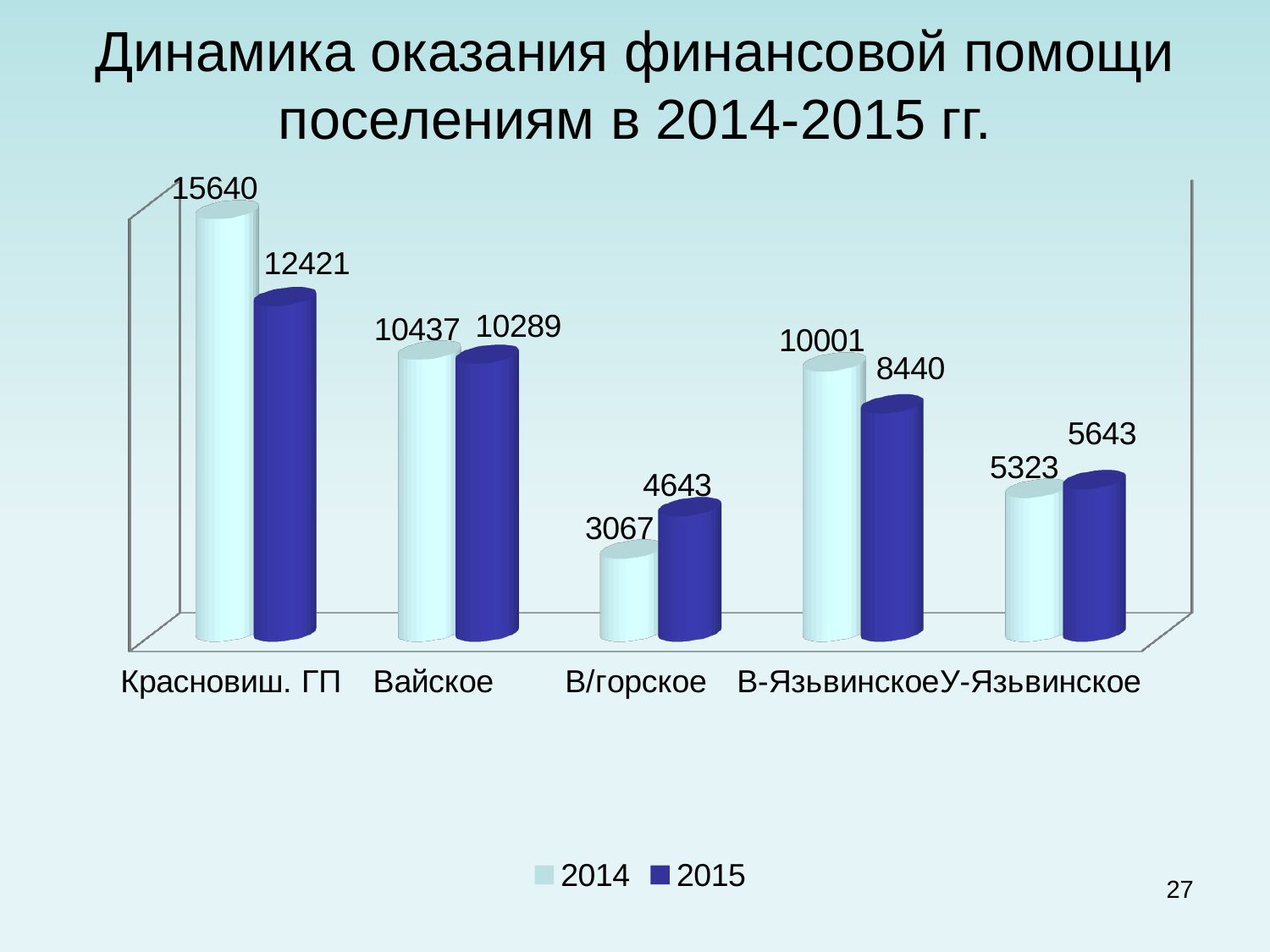
How many series does the legend list? 2 What kind of chart is shown on the slide? Bar chart What is the 2014 value for Красновиш. ГП? 15640 What is the 2015 value for В/горское? 4643 For У-Язьвинское, which year has the larger value, 2014 or 2015? 2015 What is the difference between the 2014 and 2015 values for Красновиш. ГП? 3219 Which category has the highest 2014 value? Красновиш. ГП How many categories are shown on the x axis? 5 What is the difference between the 2015 and 2014 values for В/горское? 1576 Which category has the lowest 2015 value? В/горское What is the 2015 value for В-Язьвинское? 8440 Which series is shown in dark blue according to the legend? 2015